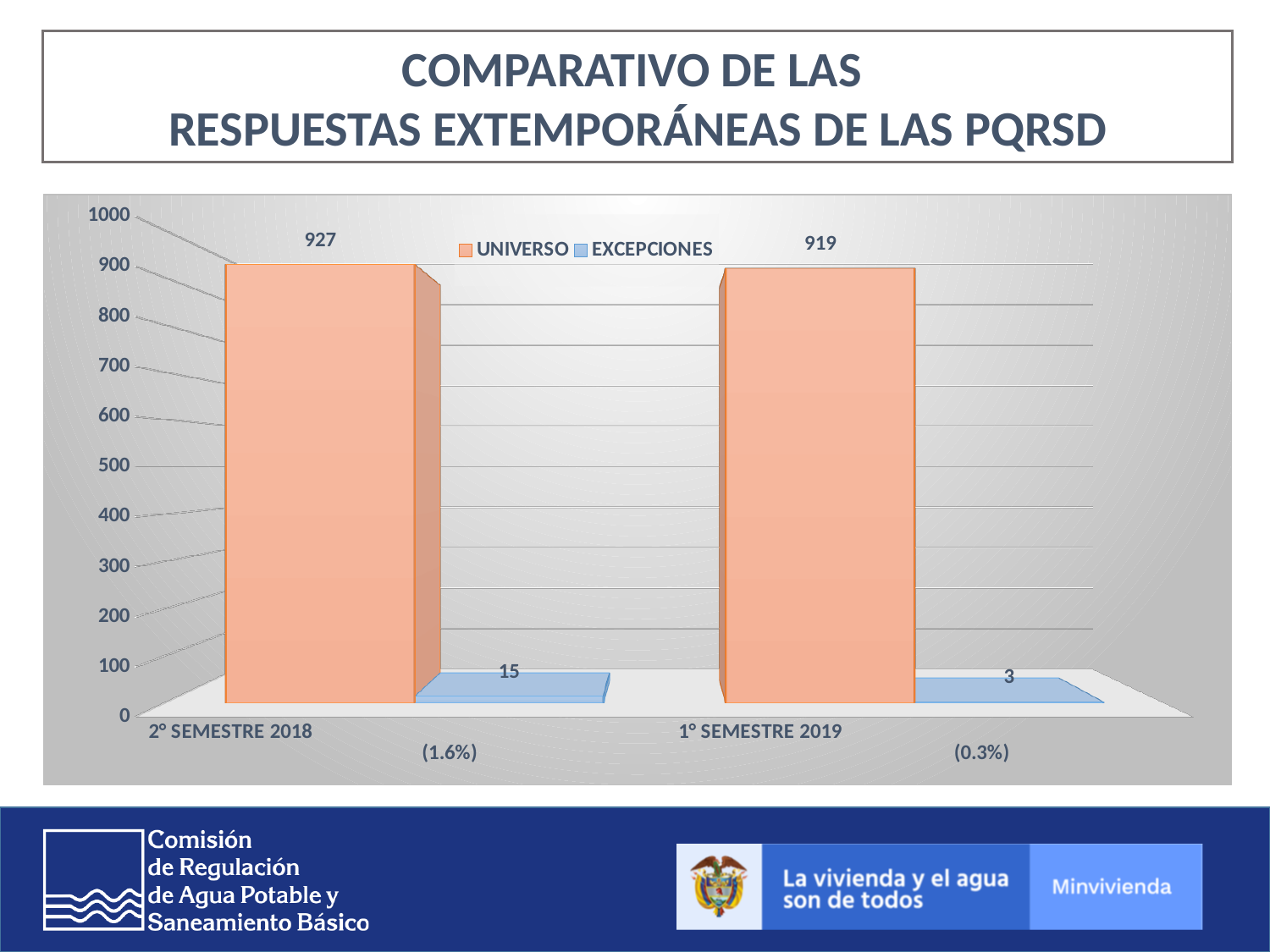
How many categories are shown on the x axis? 2 What percentage is shown below the 1° SEMESTRE 2019 category? (0.3%) What is the EXCEPCIONES value for 1° SEMESTRE 2019? 3 What kind of chart is shown on the slide? Bar chart Which period has the higher EXCEPCIONES value? 2° SEMESTRE 2018 What is the difference between the UNIVERSO values for 2° SEMESTRE 2018 and 1° SEMESTRE 2019? 8 What is the difference between the EXCEPCIONES values for 2° SEMESTRE 2018 and 1° SEMESTRE 2019? 12 What is the UNIVERSO value for 2° SEMESTRE 2018? 927 Is the UNIVERSO value for 1° SEMESTRE 2019 greater or less than 900? greater How many series does the legend list? 2 What is the UNIVERSO value for 1° SEMESTRE 2019? 919 What is the EXCEPCIONES value for 2° SEMESTRE 2018? 15